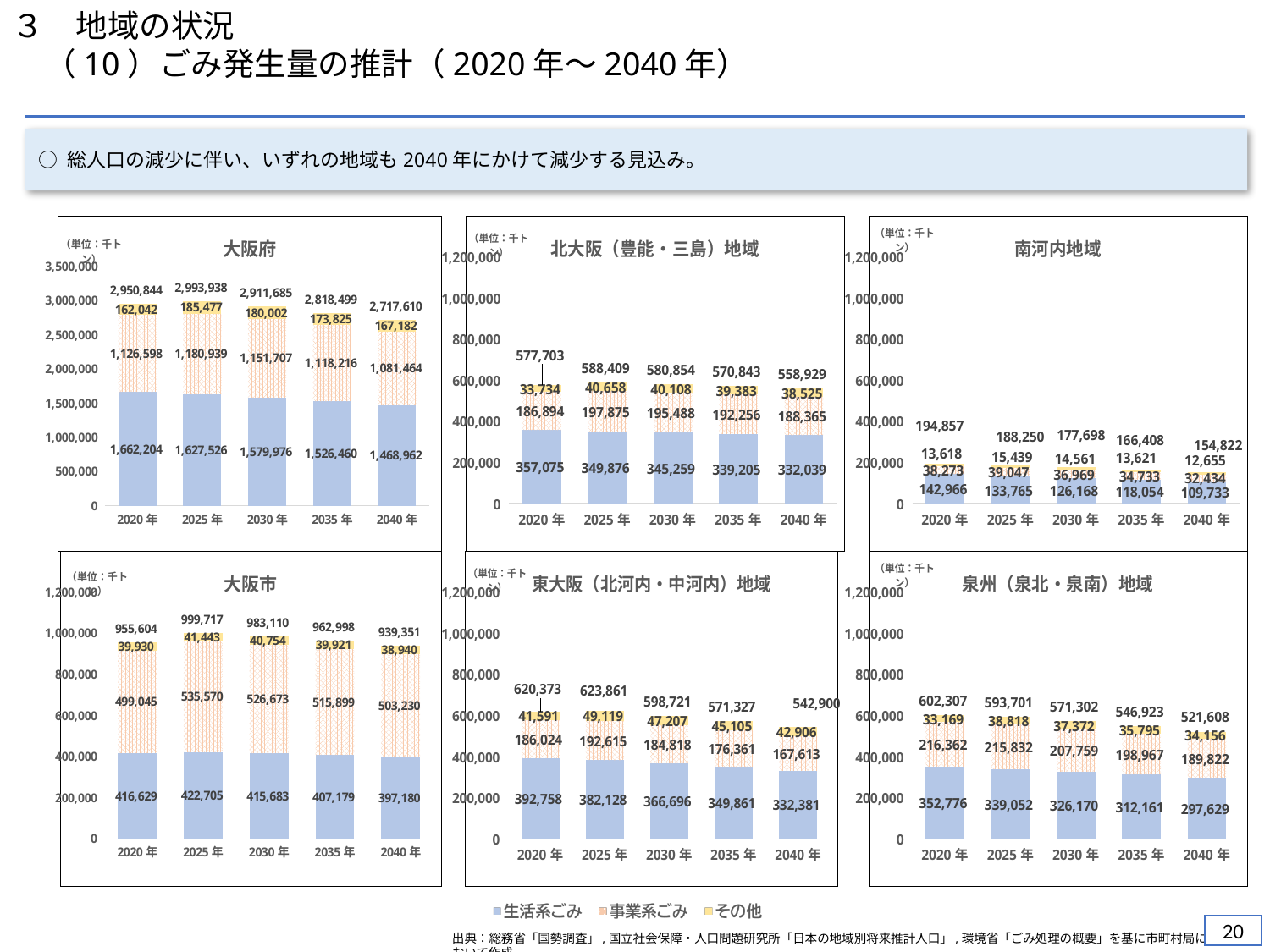
In the 北大阪（豊能・三島）地域 chart, which year has the highest total? 2025年 In the 泉州（泉北・泉南）地域 chart, is the 事業系ごみ value for 2020年 larger or smaller than the 事業系ごみ value for 2040年? larger What kind of chart is the 大阪府 chart? stacked bar chart In the 大阪府 chart, what is the 生活系ごみ value for 2020年? 1,662,204 In the 泉州（泉北・泉南）地域 chart, do the totals rise or fall from 2020年 to 2040年? fall In the 大阪府 chart, what is the total shown above the 2025年 bar? 2,993,938 In the 大阪市 chart, is the total for 2040年 greater or less than 1,000,000? less In the 大阪市 chart, what is the その他 value for 2040年? 38,940 How many years are shown on the x axis of the 南河内地域 chart? 5 In the 東大阪（北河内・中河内）地域 chart, what is the difference between the 生活系ごみ values for 2020年 and 2040年? 60,377 How many series does the legend at the bottom of the slide list? 3 In the 南河内地域 chart, which year has the lowest total? 2040年